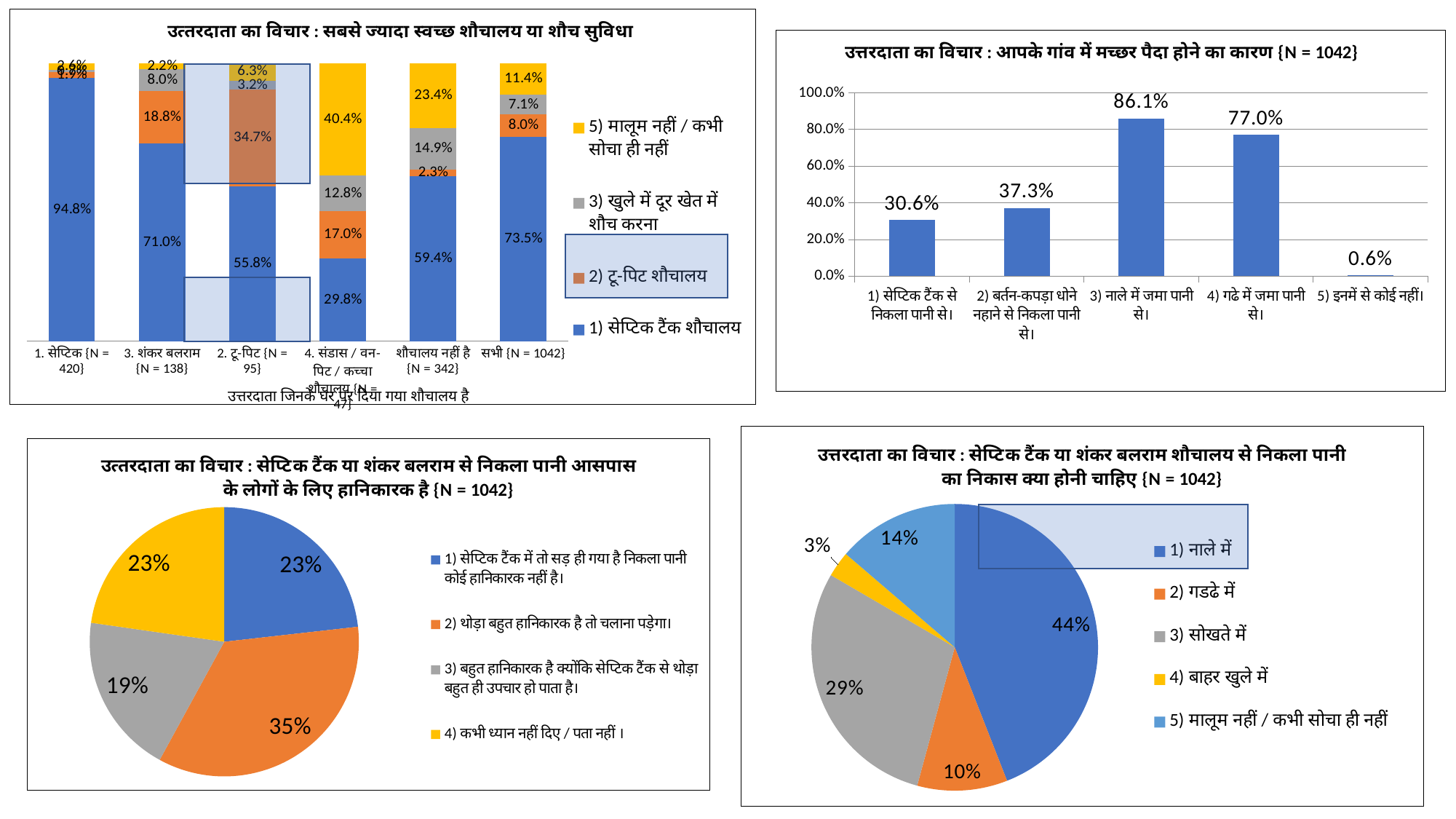
In the top-right chart (मच्छर पैदा होने का कारण), how many categories are shown on the x axis? 5 In the top-right chart (मच्छर पैदा होने का कारण), what is the value for '3) नाले में जमा पानी से'? 86.1% In the bottom-left pie chart (निकला पानी आसपास के लोगों के लिए हानिकारक है), what share does '2) थोड़ा बहुत हानिकारक है तो चलाना पड़ेगा।' have? 35% In the top-left stacked bar chart (सबसे ज्यादा स्वच्छ शौचालय), what is the value of the '1) सेप्टिक टैंक शौचालय' segment for the 'सभी {N = 1042}' bar? 73.5% In the top-left stacked bar chart (सबसे ज्यादा स्वच्छ शौचालय), how many series does the legend list? 4 In the top-left stacked bar chart, which is larger: the '5) मालूम नहीं / कभी सोचा ही नहीं' segment for '4. संडास / वन-पिट / कच्चा शौचालय' or for 'शौचालय नहीं है'? 4. संडास / वन-पिट / कच्चा शौचालय In the top-left stacked bar chart (सबसे ज्यादा स्वच्छ शौचालय), what is the value of the '2) टू-पिट शौचालय' segment for the '2. टू-पिट {N = 95}' bar? 34.7% In the top-right chart (मच्छर पैदा होने का कारण), which category has the lowest value? 5) इनमें से कोई नहीं What type of chart is the bottom-right chart (निकला पानी का निकास क्या होनी चाहिए)? Pie chart In the top-right chart (मच्छर पैदा होने का कारण), what is the difference between the values for '3) नाले में जमा पानी से' and '4) गढे में जमा पानी से'? 9.1% In the bottom-left pie chart (निकला पानी आसपास के लोगों के लिए हानिकारक है), which option has the smallest share? 3) बहुत हानिकारक है क्योंकि सेप्टिक टैंक से थोड़ा बहुत ही उपचार हो पाता है। In the bottom-right pie chart (निकला पानी का निकास क्या होनी चाहिए), what share does '3) सोखते में' have? 29%